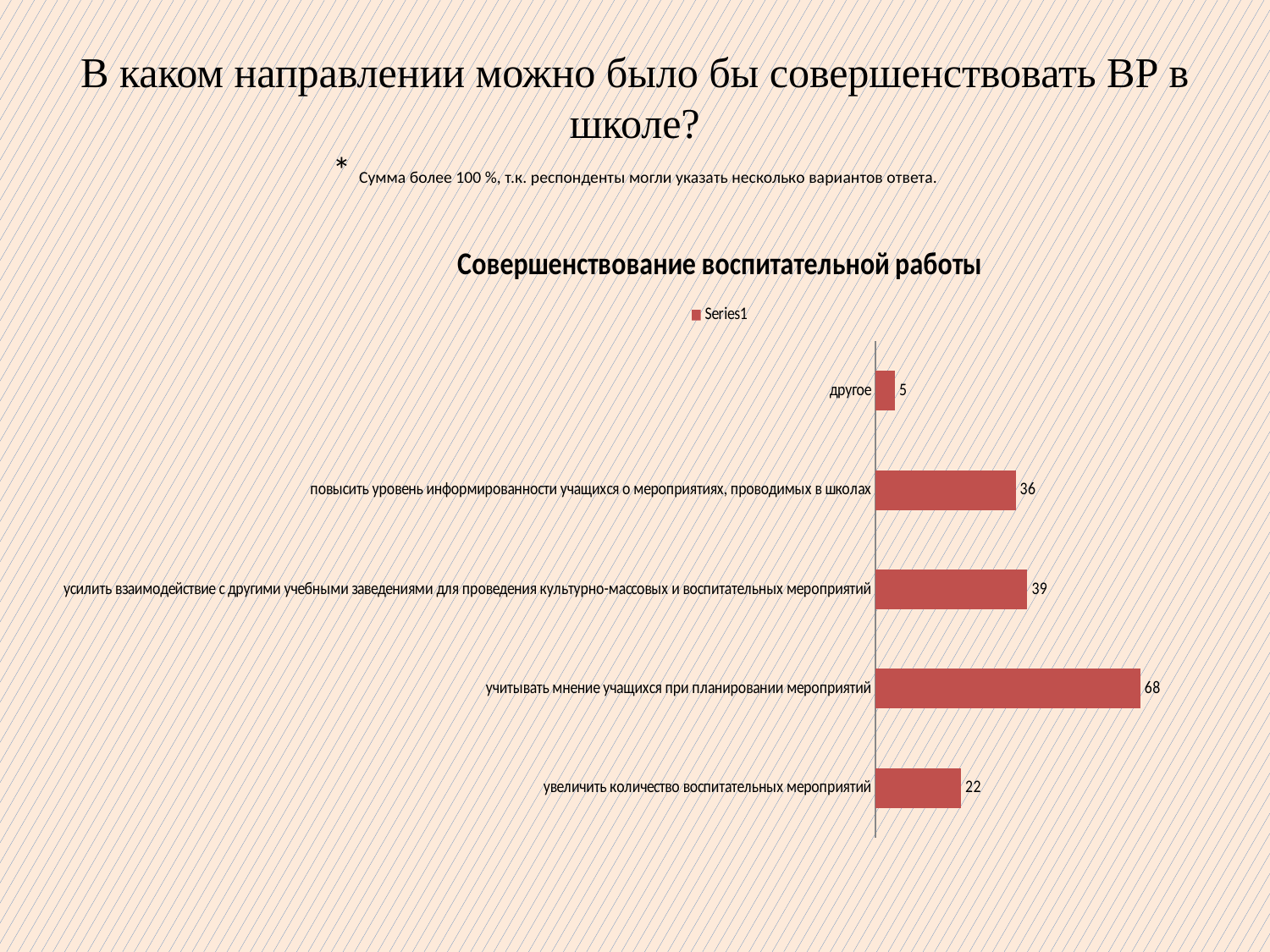
What is the value for "учитывать мнение учащихся при планировании мероприятий"? 68 Which category has the lowest value? другое What is the difference between the values for "учитывать мнение учащихся при планировании мероприятий" and "увеличить количество воспитательных мероприятий"? 46 What kind of chart is shown on the slide? bar chart Which is larger: the value for "усилить взаимодействие с другими учебными заведениями для проведения культурно-массовых и воспитательных мероприятий" or for "повысить уровень информированности учащихся о мероприятиях, проводимых в школах"? усилить взаимодействие с другими учебными заведениями для проведения культурно-массовых и воспитательных мероприятий What is the value for "повысить уровень информированности учащихся о мероприятиях, проводимых в школах"? 36 Which category has the highest value? учитывать мнение учащихся при планировании мероприятий How many categories are shown in the chart? 5 How many series does the legend list? 1 What is the title of the chart? Совершенствование воспитательной работы What is the value for "увеличить количество воспитательных мероприятий"? 22 What is the value for "другое"? 5